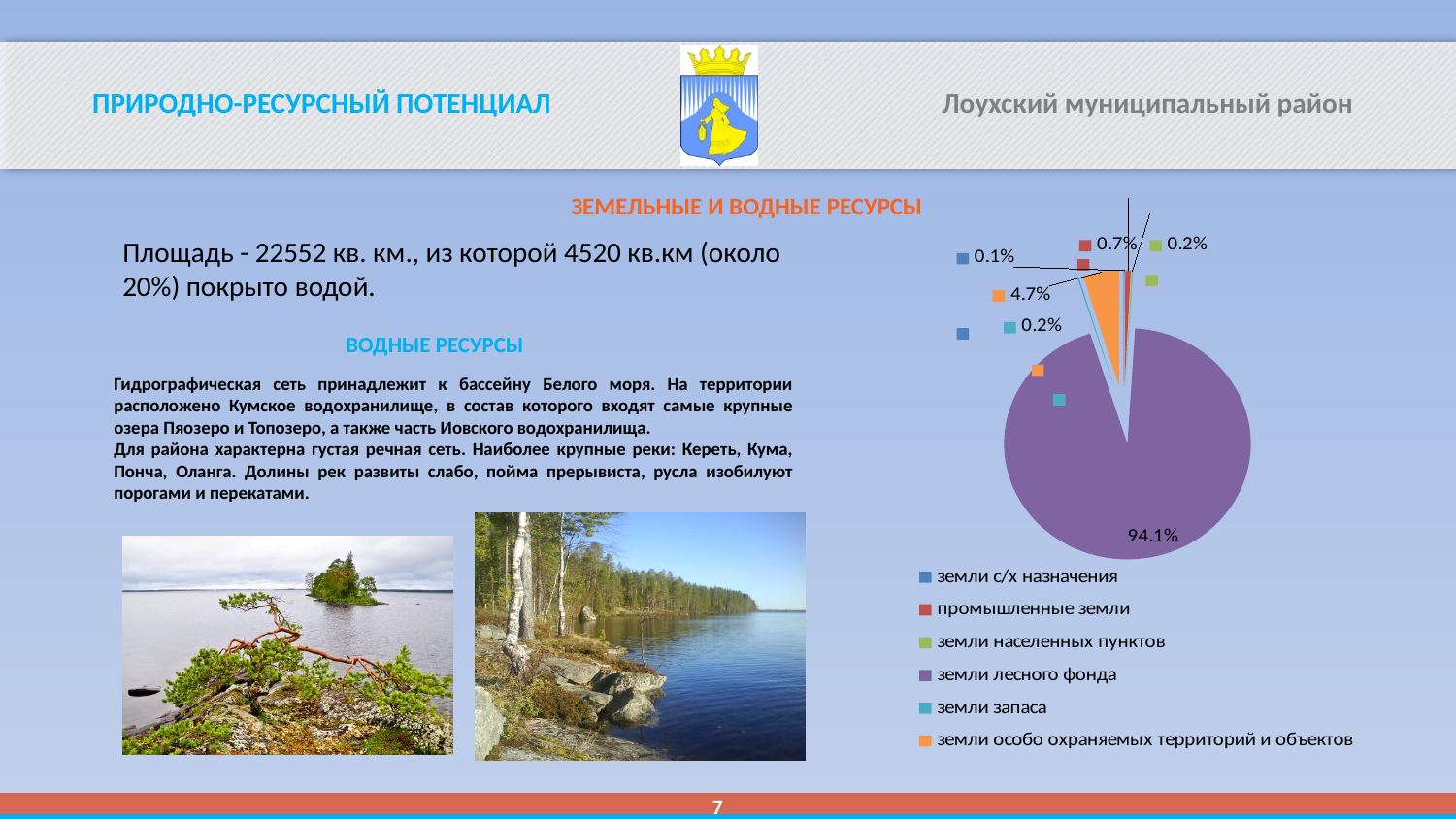
What share of the pie chart is промышленные земли? 0.7% Which category has the smallest slice in the pie chart? земли с/х назначения What share of the pie chart is земли особо охраняемых территорий и объектов? 4.7% Which category has the largest slice in the pie chart? земли лесного фонда What share of the pie chart is земли с/х назначения? 0.1% Which is larger: the share of промышленные земли or the share of земли особо охраняемых территорий и объектов? земли особо охраняемых территорий и объектов What is the difference between the shares of земли лесного фонда and земли особо охраняемых территорий и объектов? 89.4% What share of the pie chart is земли лесного фонда? 94.1% What colour is the slice for земли лесного фонда in the pie chart? purple What kind of chart is shown on the slide? pie chart What share of the pie chart is земли населенных пунктов? 0.2% How many categories does the legend of the pie chart list? 6